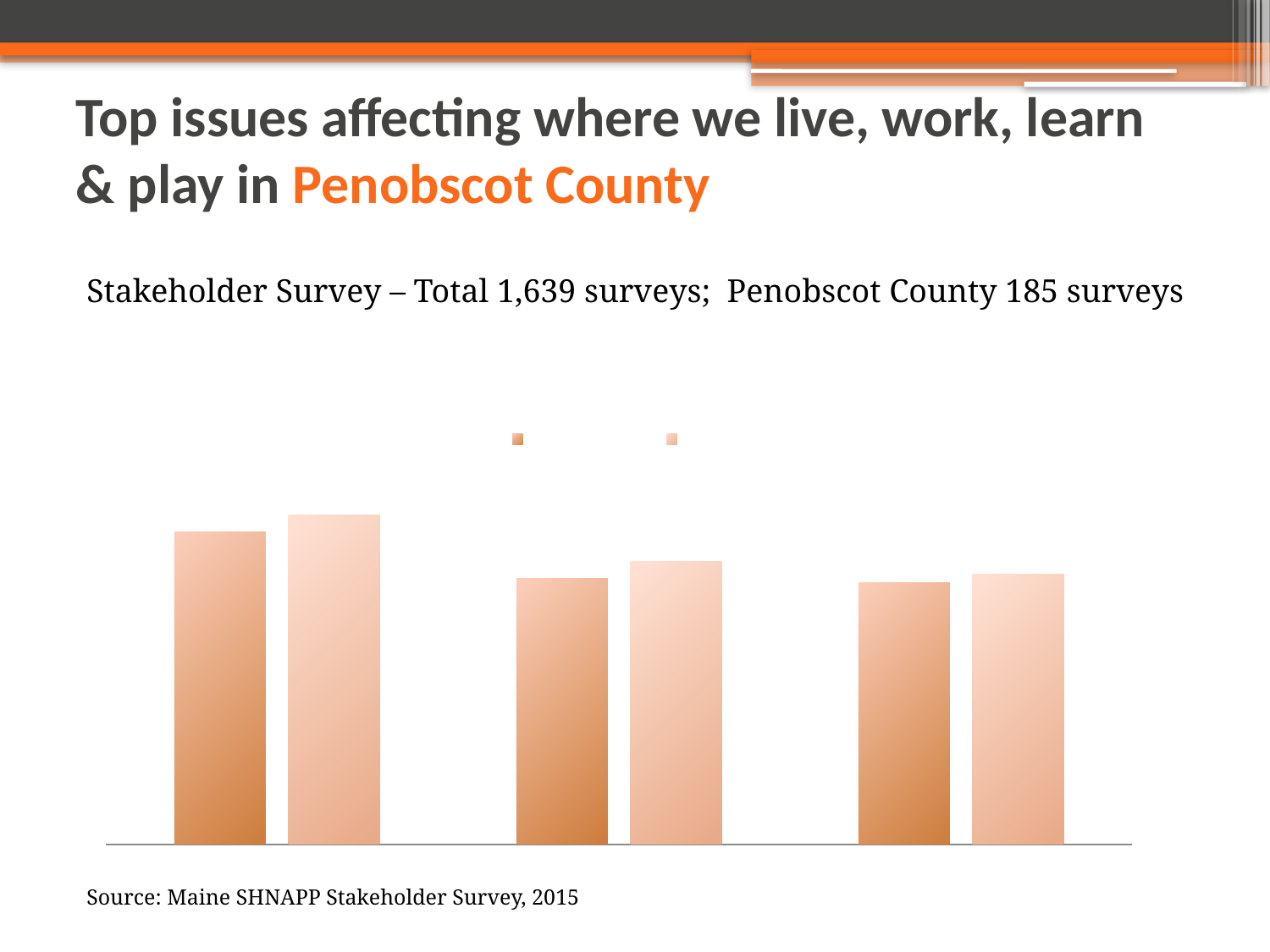
In the leftmost group of bars, is the darker orange bar or the lighter orange bar taller? the lighter orange bar How many series does the chart's legend list? 2 Do the darker orange bars rise or fall from the leftmost group to the rightmost group? fall Which group of bars is the tallest: the leftmost, middle, or rightmost group? leftmost How many bars are plotted in the chart in total? 6 What colours are the two series in the chart? darker orange and lighter orange In the middle group of bars, is the darker orange bar or the lighter orange bar taller? the lighter orange bar What kind of chart is shown on the slide? bar chart How many groups of bars are plotted in the chart? 3 Is the darker orange bar in the leftmost group taller or shorter than the darker orange bar in the rightmost group? taller What source is cited below the chart? Maine SHNAPP Stakeholder Survey, 2015